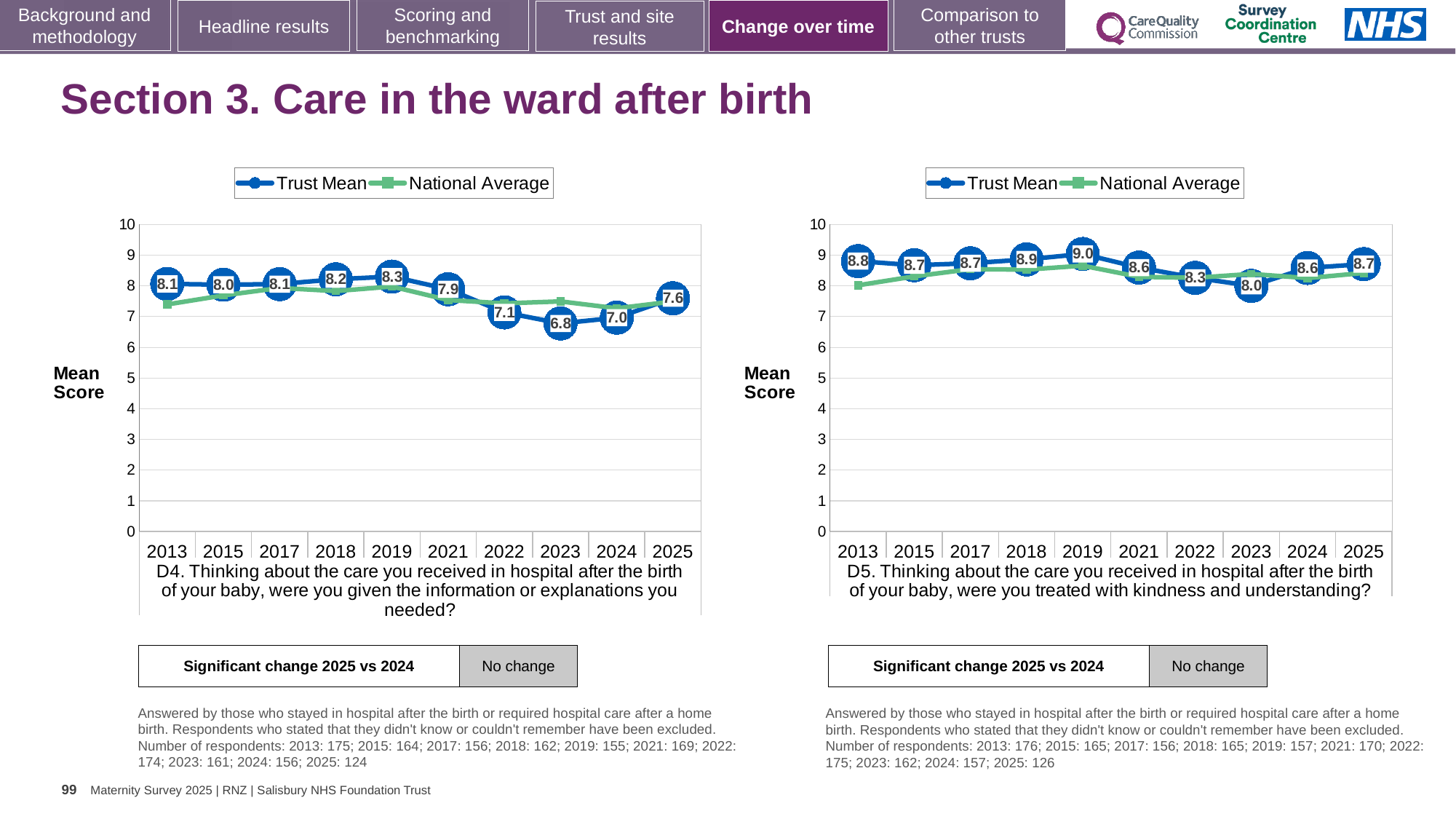
In the D4 chart on the left, is the Trust Mean score higher in 2013 or in 2022? 2013 In the D5 chart on the right, what is the Trust Mean score for 2019? 9.0 How many series does the legend of the D5 chart on the right list? 2 In the D5 chart on the right, what is the difference between the Trust Mean scores for 2025 and 2023? 0.7 In the D4 chart on the left, did the Trust Mean score rise or fall between 2019 and 2023? Fall In the D5 chart on the right, is the National Average for 2013 greater or less than 9? less How many years are plotted on the x axis of the D4 chart on the left? 10 In the D4 chart on the left, which year has the lowest Trust Mean score? 2023 In the D4 chart on the left, what is the Trust Mean score for 2025? 7.6 In the D4 chart on the left, what is the difference between the Trust Mean scores for 2019 and 2023? 1.5 What type of chart is the D4 chart on the left? Line chart In the D5 chart on the right, which year has the highest Trust Mean score? 2019